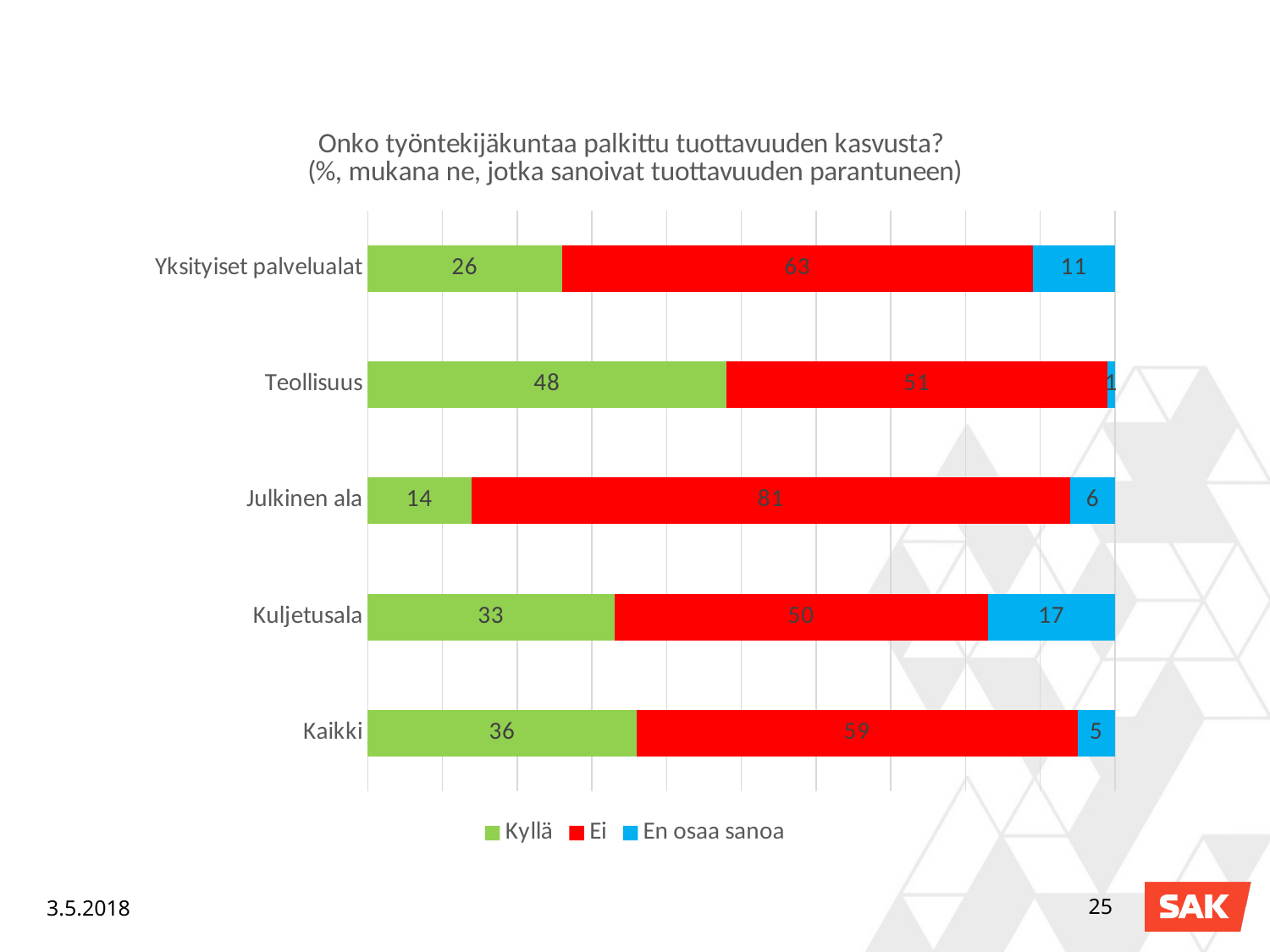
Which is larger: the "Kyllä" value for Kuljetusala or the "Kyllä" value for Kaikki? Kaikki Which category has the lowest "Kyllä" value? Julkinen ala What is the difference between the "Ei" value for Yksityiset palvelualat and the "Ei" value for Kaikki? 4 Which series is shown in red in the legend? Ei What is the value of "En osaa sanoa" for Kuljetusala? 17 Which category has the highest "Ei" value? Julkinen ala What is the value of "Ei" for Julkinen ala? 81 What kind of chart is shown on the slide? Stacked bar chart What is the value of "Kyllä" for Teollisuus? 48 What is the total of the stacked bar for Teollisuus? 100 How many series does the legend list? 3 How many categories are shown on the chart? 5